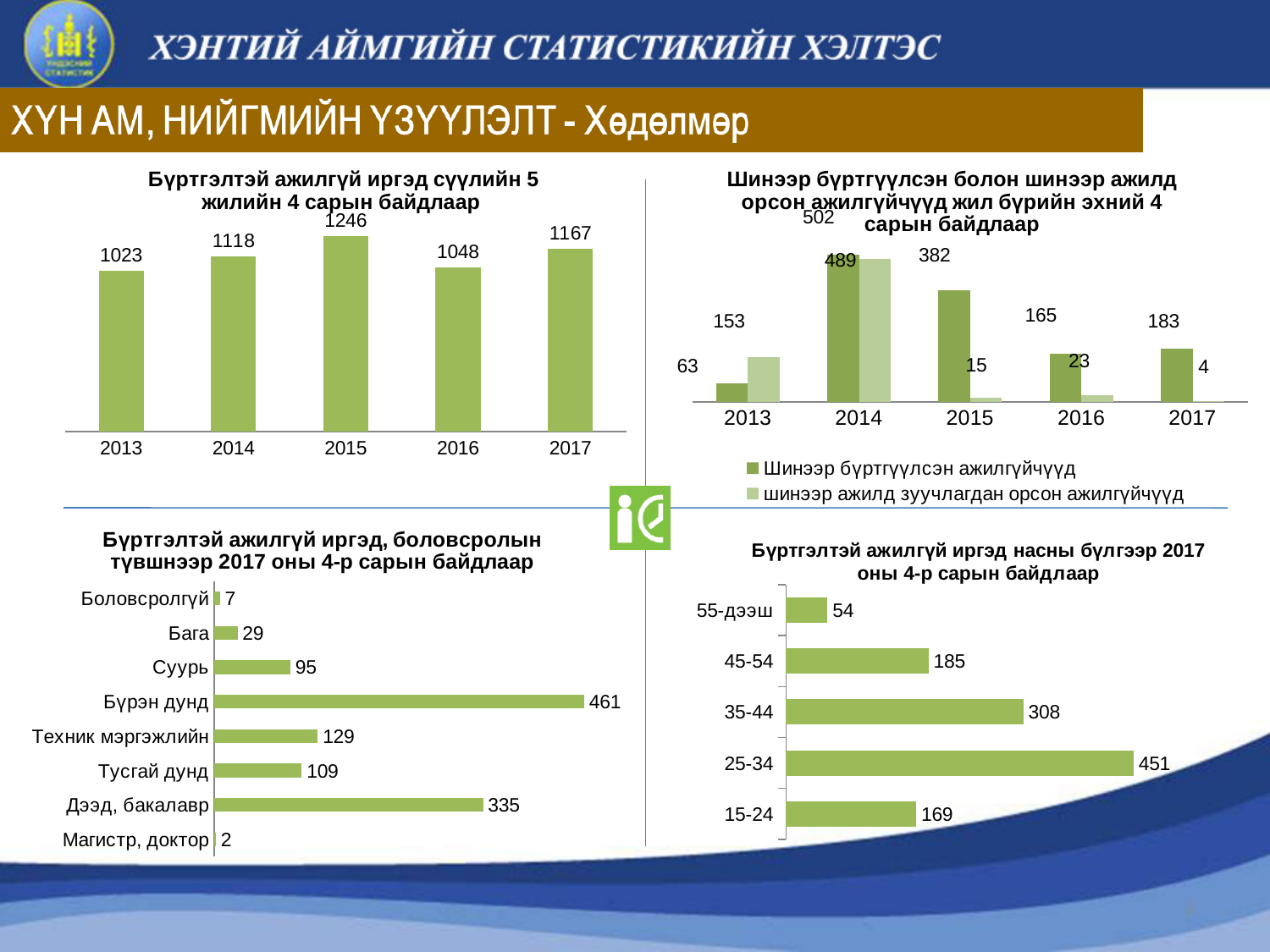
In the bottom-left chart (Бүртгэлтэй ажилгүй иргэд, боловсролын түвшнээр), which category has the highest value? Бүрэн дунд In the top-right chart (Шинээр бүртгүүлсэн болон шинээр ажилд орсон ажилгүйчүүд), which year has the highest value for Шинээр бүртгүүлсэн ажилгүйчүүд? 2014 In the top-left chart (Бүртгэлтэй ажилгүй иргэд сүүлийн 5 жилийн 4 сарын байдлаар), which year has the lowest value? 2013 In the top-left chart (Бүртгэлтэй ажилгүй иргэд сүүлийн 5 жилийн 4 сарын байдлаар), what is the value for 2015? 1246 In the bottom-left chart (Бүртгэлтэй ажилгүй иргэд, боловсролын түвшнээр), how many categories are shown? 8 What type of chart is the bottom-right chart (Бүртгэлтэй ажилгүй иргэд насны бүлгээр)? Bar chart In the top-right chart (Шинээр бүртгүүлсэн болон шинээр ажилд орсон ажилгүйчүүд), how many series does the legend list? 2 In the bottom-right chart (Бүртгэлтэй ажилгүй иргэд насны бүлгээр), which is larger, the value for 45-54 or the value for 15-24? 45-54 In the top-right chart (Шинээр бүртгүүлсэн болон шинээр ажилд орсон ажилгүйчүүд), what is the value for Шинээр бүртгүүлсэн ажилгүйчүүд in 2015? 382 In the top-right chart (Шинээр бүртгүүлсэн болон шинээр ажилд орсон ажилгүйчүүд), what is the value for шинээр ажилд зуучлагдан орсон ажилгүйчүүд in 2017? 4 In the top-left chart (Бүртгэлтэй ажилгүй иргэд сүүлийн 5 жилийн 4 сарын байдлаар), what is the difference between the 2017 and 2016 values? 119 In the bottom-left chart (Бүртгэлтэй ажилгүй иргэд, боловсролын түвшнээр), what is the value for Дээд, бакалавр? 335